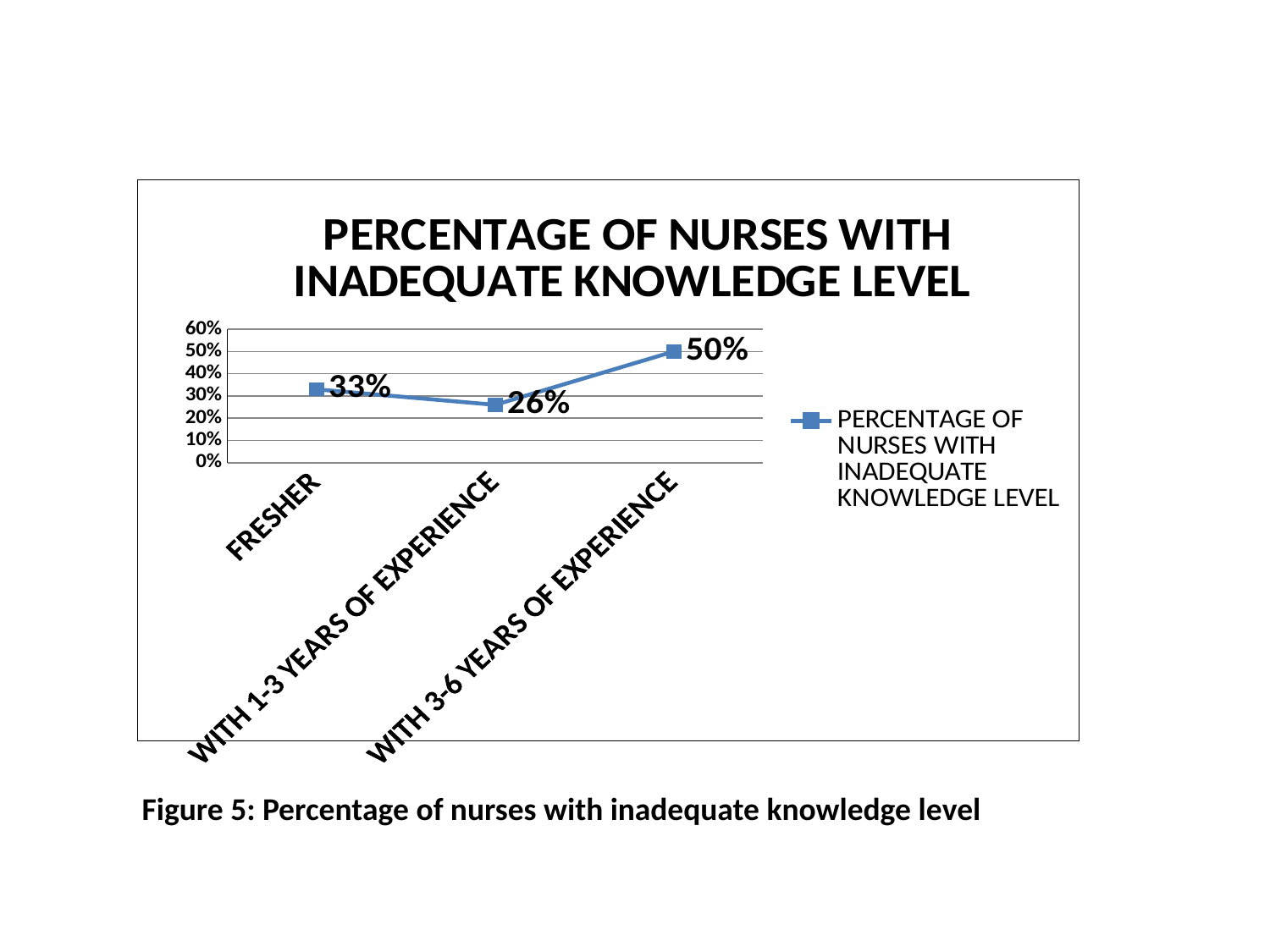
How many categories are shown on the x axis of the chart? 3 Which has a higher percentage of nurses with inadequate knowledge level, FRESHER or WITH 1-3 YEARS OF EXPERIENCE? FRESHER What is the difference between the percentage for FRESHER and WITH 1-3 YEARS OF EXPERIENCE? 7% Is the value for WITH 3-6 YEARS OF EXPERIENCE greater or less than 40%? greater What is the percentage of nurses with inadequate knowledge level for FRESHER? 33% How many series does the chart legend list? 1 What is the percentage of nurses with inadequate knowledge level for WITH 3-6 YEARS OF EXPERIENCE? 50% What is the percentage of nurses with inadequate knowledge level for WITH 1-3 YEARS OF EXPERIENCE? 26% What kind of chart is shown on the slide? Line chart Which category has the highest percentage of nurses with inadequate knowledge level? WITH 3-6 YEARS OF EXPERIENCE Which category has the lowest percentage of nurses with inadequate knowledge level? WITH 1-3 YEARS OF EXPERIENCE What is the difference between the percentage for WITH 3-6 YEARS OF EXPERIENCE and FRESHER? 17%